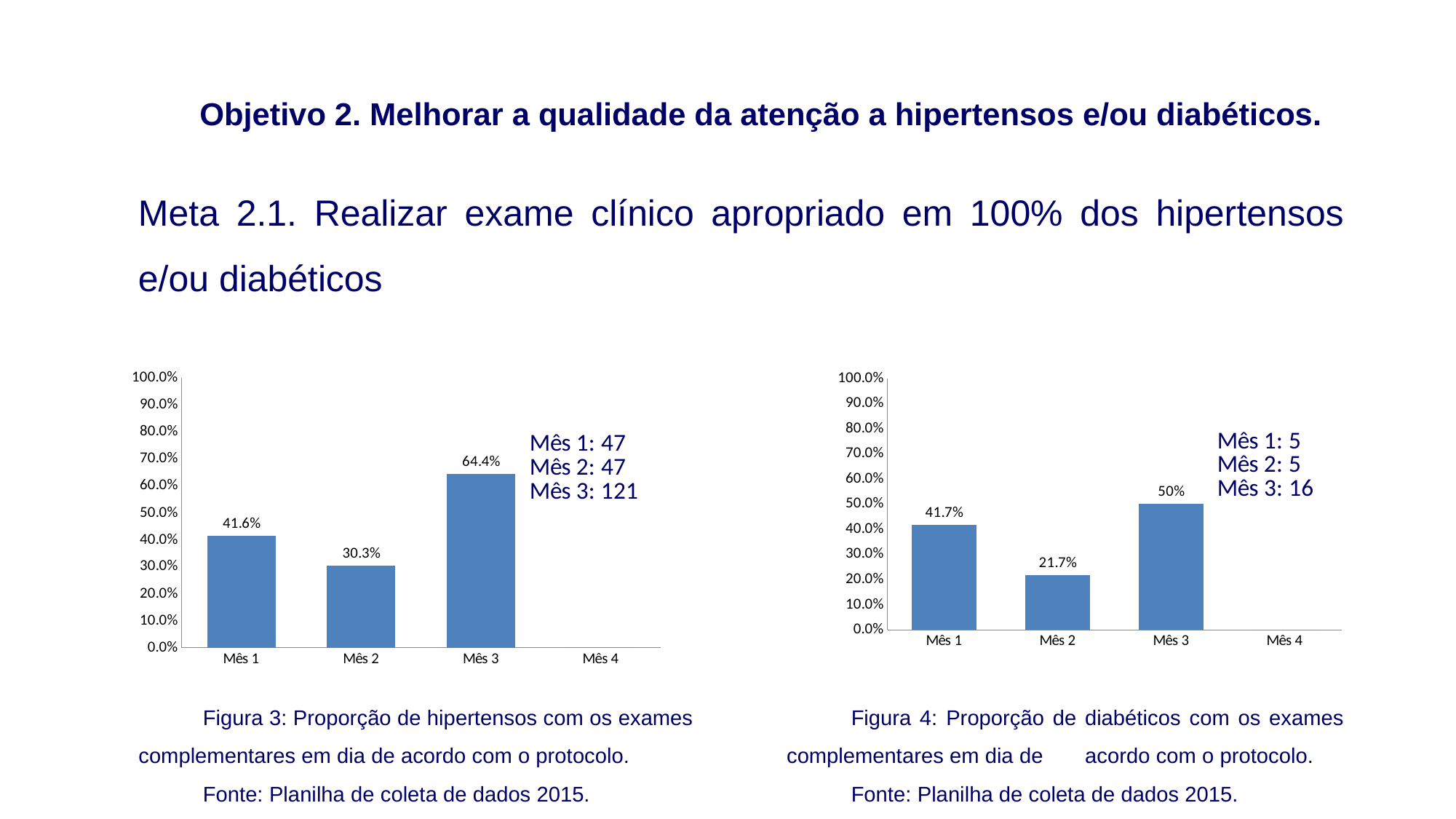
In the right chart (Figura 4, diabéticos), what is the value for Mês 2? 21.7% In the left chart (Figura 3, hipertensos), what is the value for Mês 3? 64.4% What kind of chart is the left chart (Figura 3, hipertensos)? Bar chart In the left chart (Figura 3, hipertensos), what is the difference between the values for Mês 3 and Mês 1? 22.8 percentage points In the right chart (Figura 4, diabéticos), what is the difference between the values for Mês 3 and Mês 2? 28.3 percentage points In the left chart (Figura 3, hipertensos), is the value for Mês 3 greater or less than 60%? greater In the left chart (Figura 3, hipertensos), what is the highest value shown on the vertical axis? 100.0% How many bars are plotted in the right chart (Figura 4, diabéticos)? 3 In the right chart (Figura 4, diabéticos), which month has the highest value? Mês 3 In the right chart (Figura 4, diabéticos), which is larger, the value for Mês 1 or the value for Mês 2? Mês 1 In the left chart (Figura 3, hipertensos), what is the value for Mês 1? 41.6%